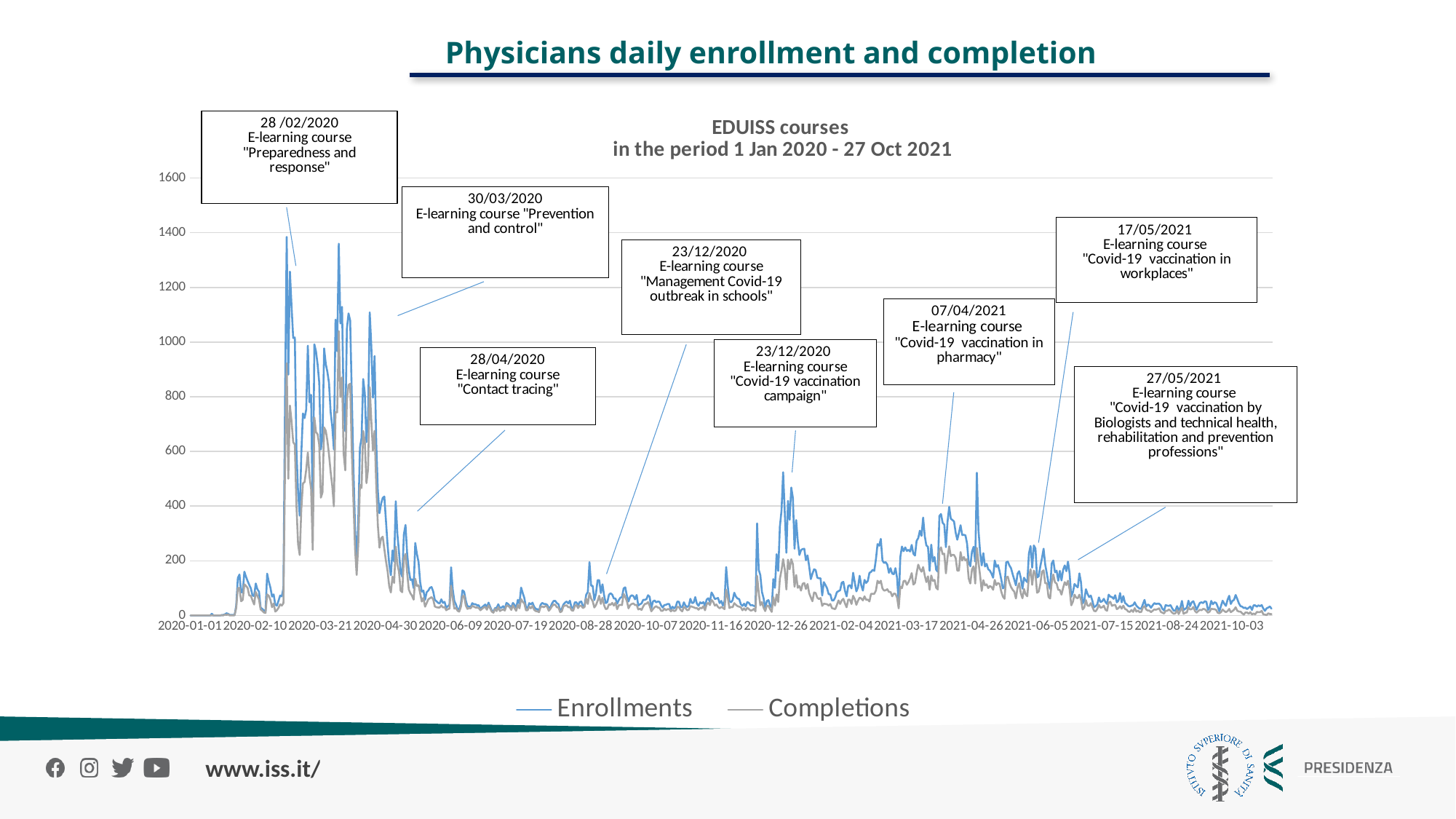
In October 2021, are the Enrollments values greater or less than 200? less What is the title of the chart? EDUISS courses in the period 1 Jan 2020 - 27 Oct 2021 Is the Enrollments peak near 2020-12-26 greater or less than 400? greater Is the highest daily Enrollments value on the chart greater or less than 1200? greater Which e-learning course is annotated with the date 28/02/2020? Preparedness and response Between late April 2020 and July 2020, do the Enrollments values rise or fall? fall How many series does the chart's legend list? 2 Which series reaches a higher peak, Enrollments or Completions? Enrollments What kind of chart is shown on the slide? line chart